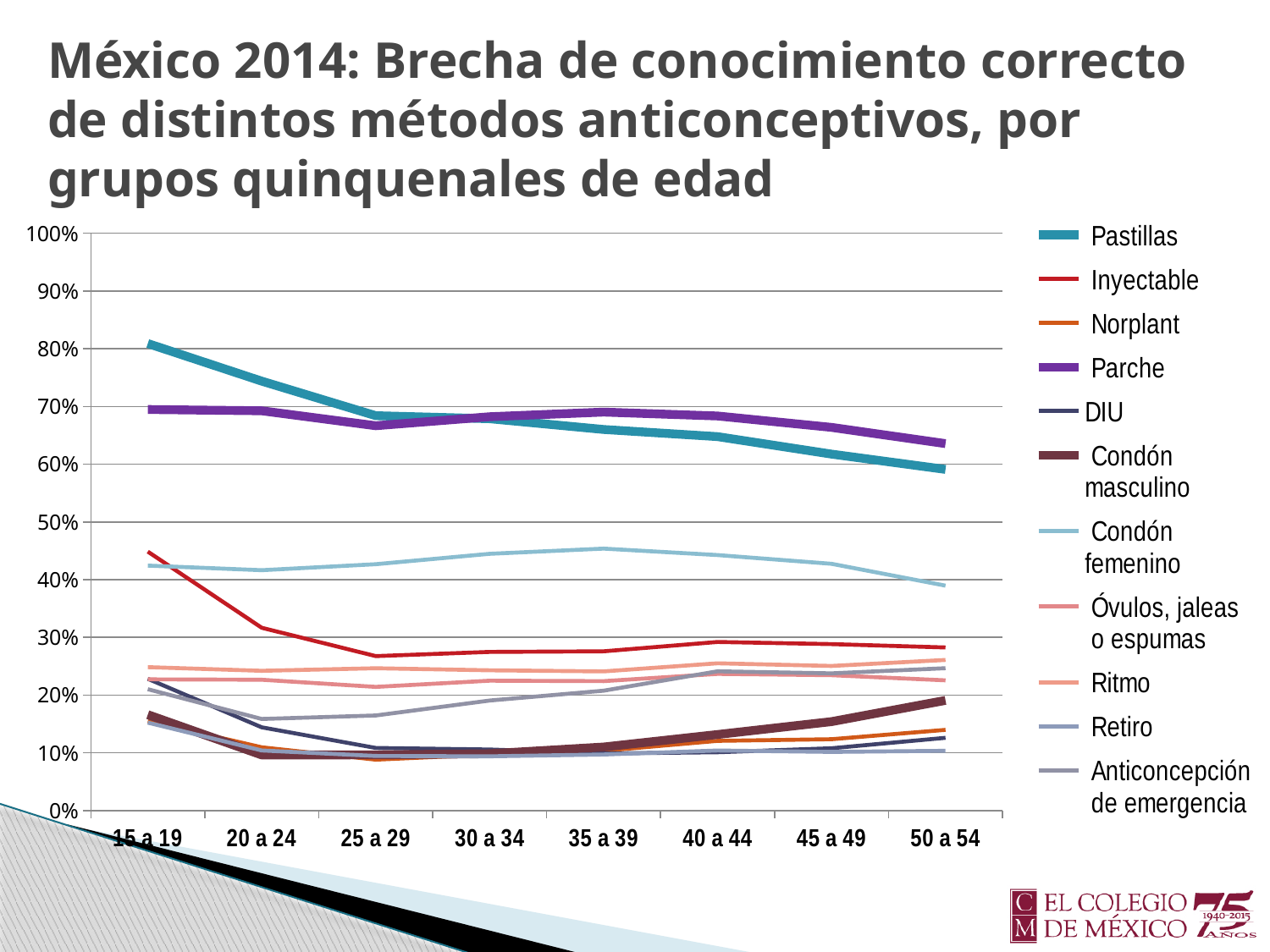
Is the value for Condón femenino in the 35 a 39 group greater or less than 50%? less Is the value for Anticoncepción de emergencia in the 20 a 24 group greater or less than 20%? less In the 50 a 54 group, which is larger: Parche or Pastillas? Parche How many age groups are shown on the x axis? 8 Which series has the highest value in the 15 a 19 group? Pastillas Is the value for Pastillas in the 15 a 19 group greater or less than 70%? greater In which age group does Inyectable reach its highest value? 15 a 19 Which series is listed first in the legend? Pastillas How many series does the legend list? 11 Does the Pastillas line rise or fall from the 15 a 19 group to the 50 a 54 group? falls What kind of chart is shown on the slide? line chart